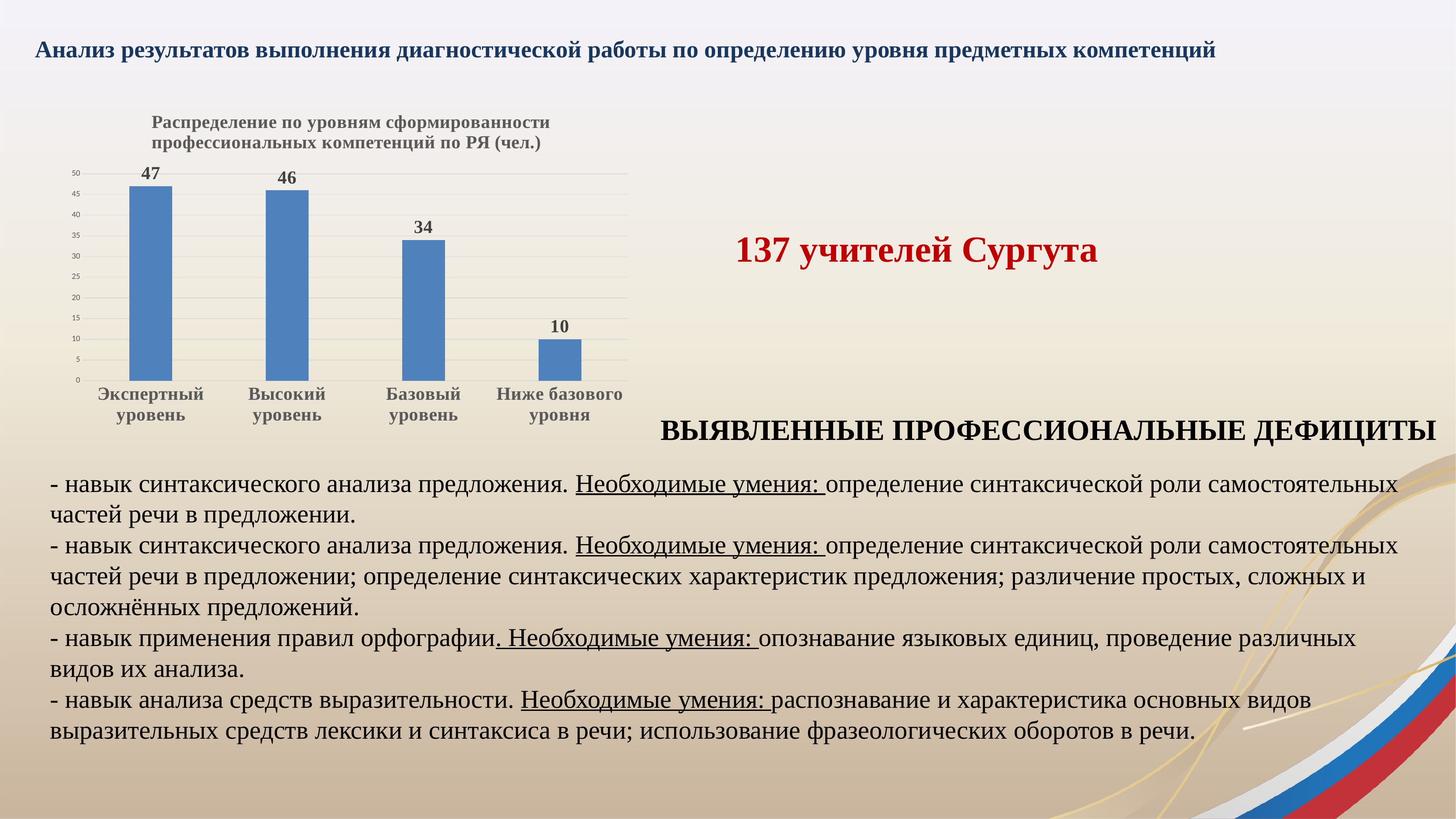
What is the difference between the values for Базовый уровень and Ниже базового уровня? 24 How many categories are shown on the chart? 4 Which is larger, the value for Высокий уровень or the value for Базовый уровень? Высокий уровень Which category has the highest value? Экспертный уровень What kind of chart is shown on the slide? Bar chart What is the value for Базовый уровень? 34 What is the value for Ниже базового уровня? 10 Do the values rise or fall from left to right along the x axis? Fall What is the value for Экспертный уровень? 47 Which category has the lowest value? Ниже базового уровня What is the value for Высокий уровень? 46 What is the difference between the values for Экспертный уровень and Базовый уровень? 13